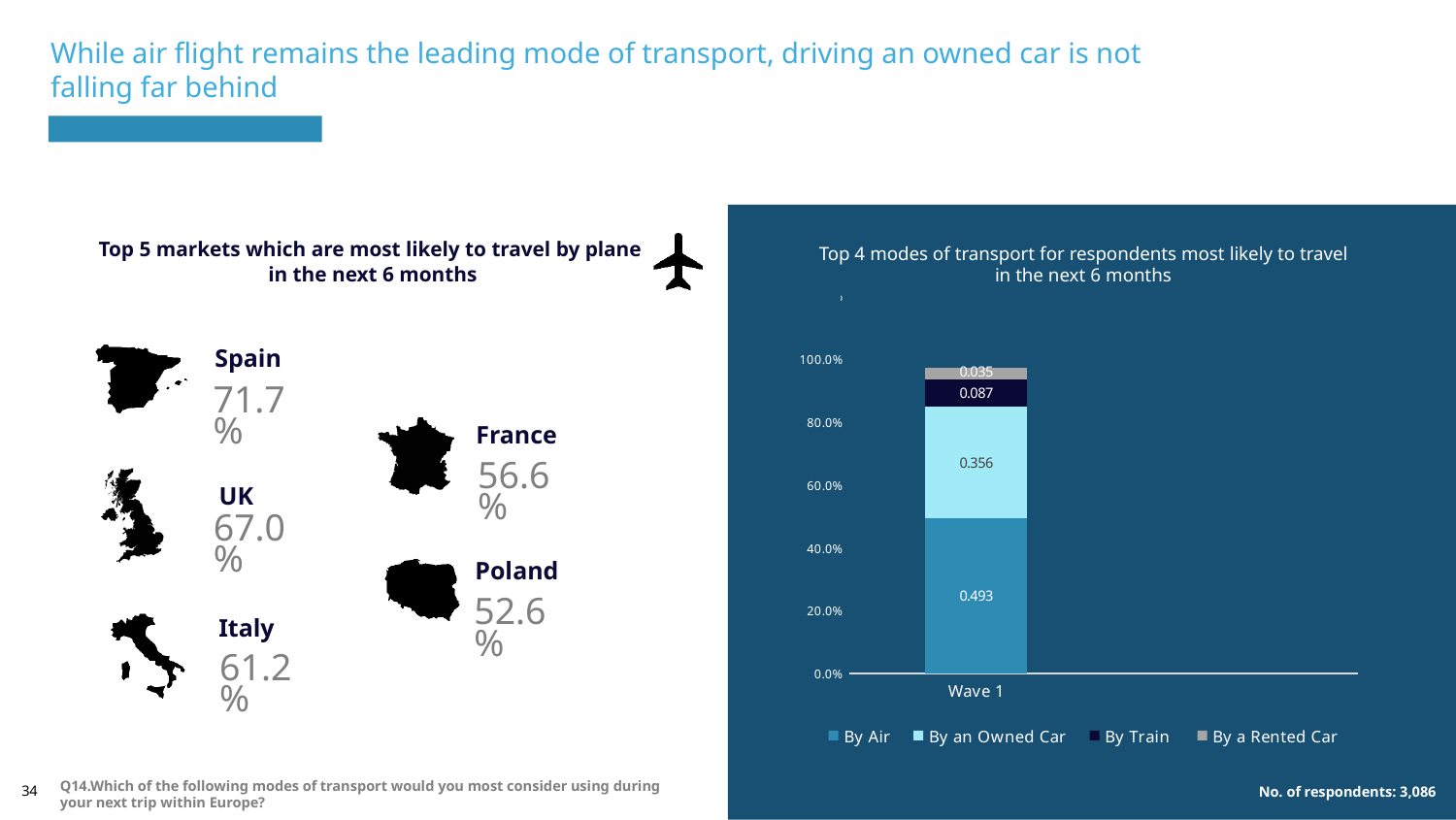
How many categories are shown on the x axis of the chart? 1 In the chart, what is the value for By Air in Wave 1? 0.493 Which mode of transport has the lowest value in the chart? By a Rented Car What is the total of the stacked bar for Wave 1 in the chart? 0.971 In the chart, what is the value for By Train in Wave 1? 0.087 What kind of chart is shown on the right side of the slide? Stacked bar chart Which mode of transport has the highest value in the chart? By Air In the chart, what is the value for By a Rented Car in Wave 1? 0.035 In the chart, what is the value for By an Owned Car in Wave 1? 0.356 Which is larger in the chart, the value for By Train or the value for By a Rented Car? By Train How many series does the chart's legend list? 4 What is the difference between the By Air value and the By an Owned Car value in the chart? 0.137